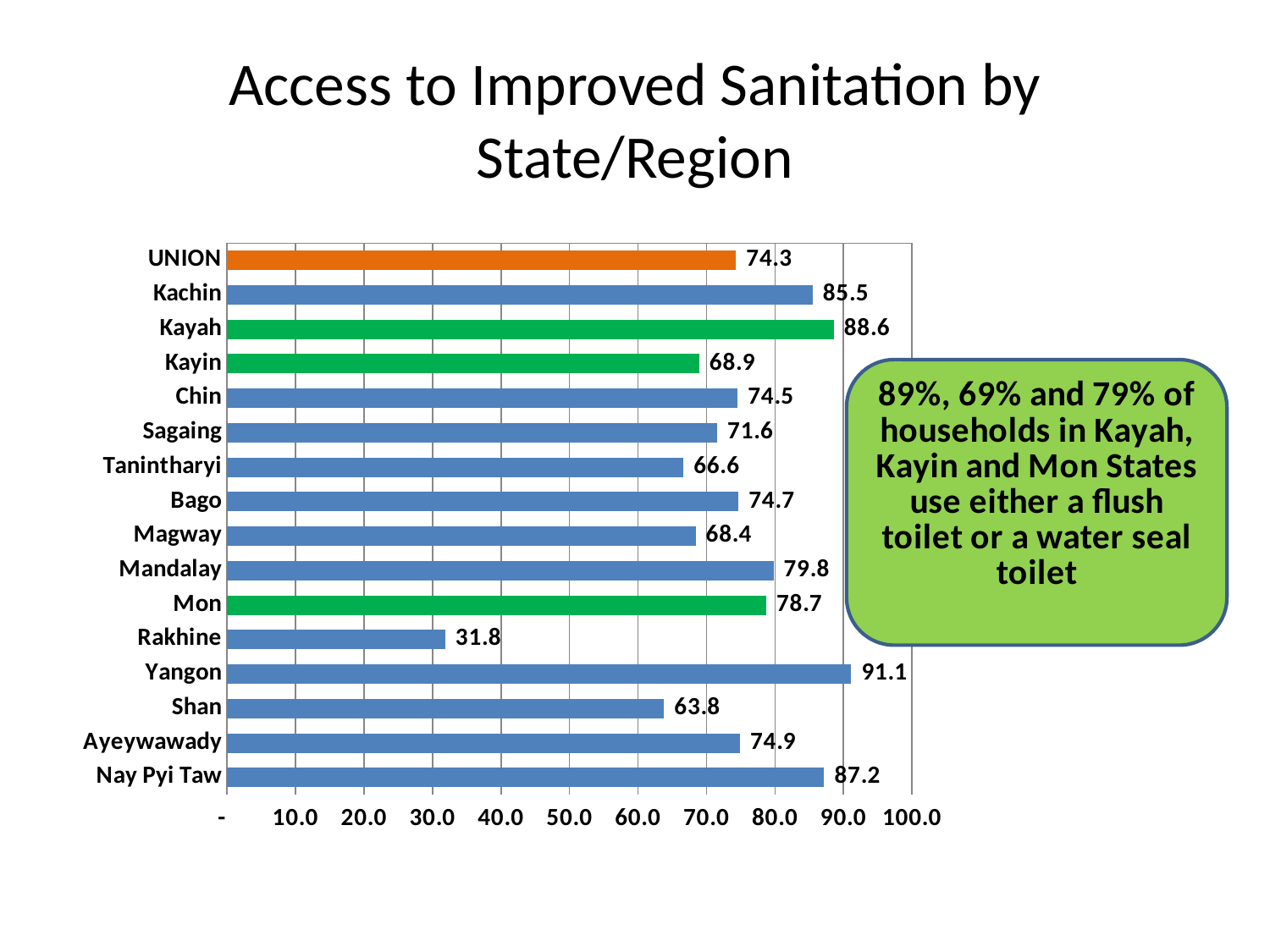
Is the value for Shan greater or less than 70.0? less Which state/region has the highest value? Yangon What is the value for Kayah? 88.6 What is the difference between the values for Yangon and Rakhine? 59.3 What is the value for Rakhine? 31.8 How many categories (bars) are shown in the chart? 16 What is the title of the chart on the slide? Access to Improved Sanitation by State/Region Which state/region has the lowest value? Rakhine What kind of chart is shown on the slide? bar chart Which is larger, the value for Mandalay or the value for Mon? Mandalay What is the value for UNION? 74.3 What is the difference between the values for Kayah and Kayin? 19.7